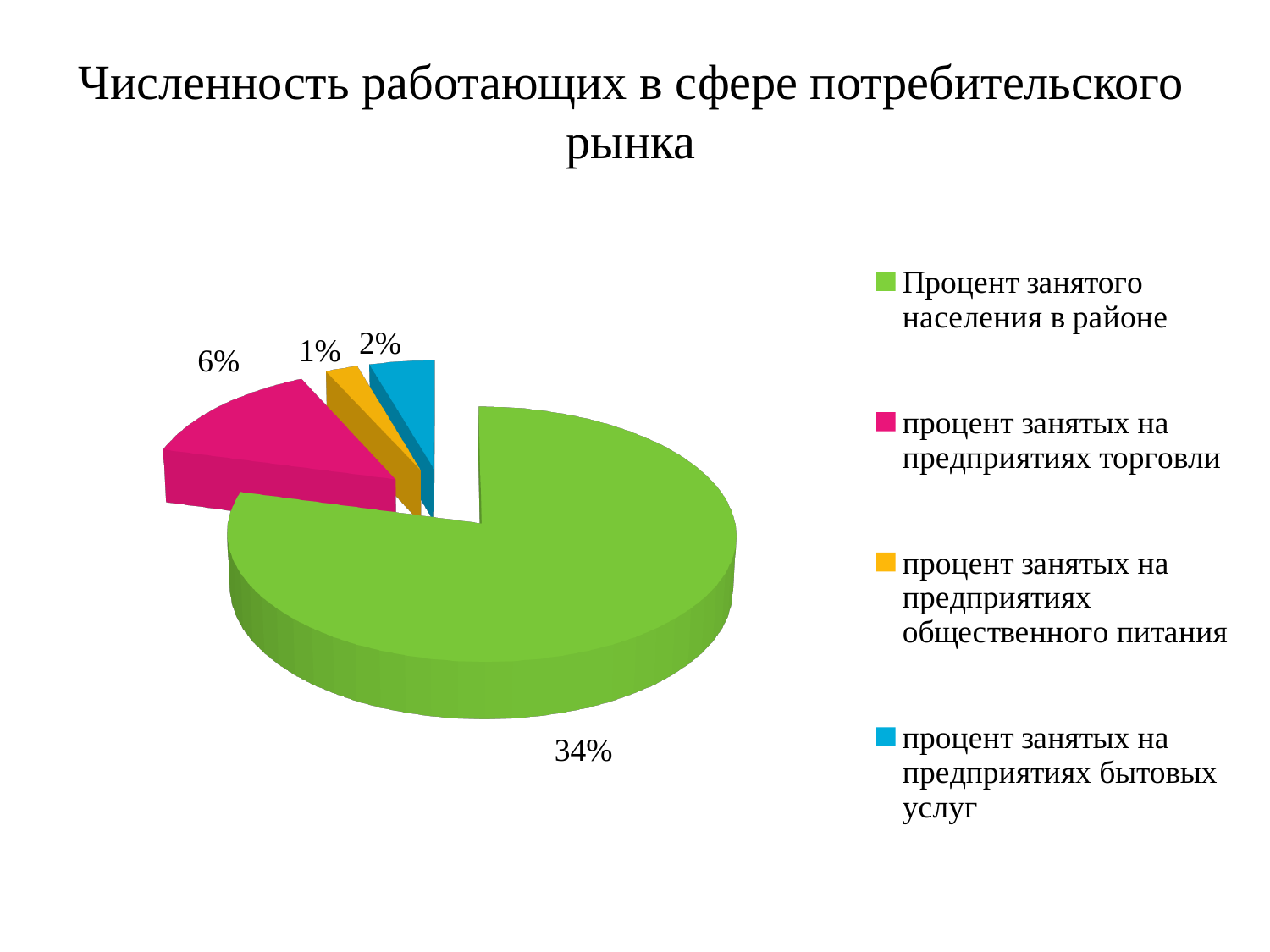
How many slices does the pie chart have? 4 What value is shown for "процент занятых на предприятиях торговли"? 6% What is the difference between the value for "Процент занятого населения в районе" and the value for "процент занятых на предприятиях торговли"? 28% What value is shown for "процент занятых на предприятиях бытовых услуг"? 2% What value is shown for "Процент занятого населения в районе"? 34% What value is shown for "процент занятых на предприятиях общественного питания"? 1% Which is larger: the value for "процент занятых на предприятиях бытовых услуг" or the value for "процент занятых на предприятиях общественного питания"? процент занятых на предприятиях бытовых услуг Which category has the smallest slice of the pie? процент занятых на предприятиях общественного питания What colour is the slice for "процент занятых на предприятиях торговли"? Pink What type of chart is shown on the slide? Pie chart What is the title of the chart on the slide? Численность работающих в сфере потребительского рынка Which category has the largest slice of the pie? Процент занятого населения в районе